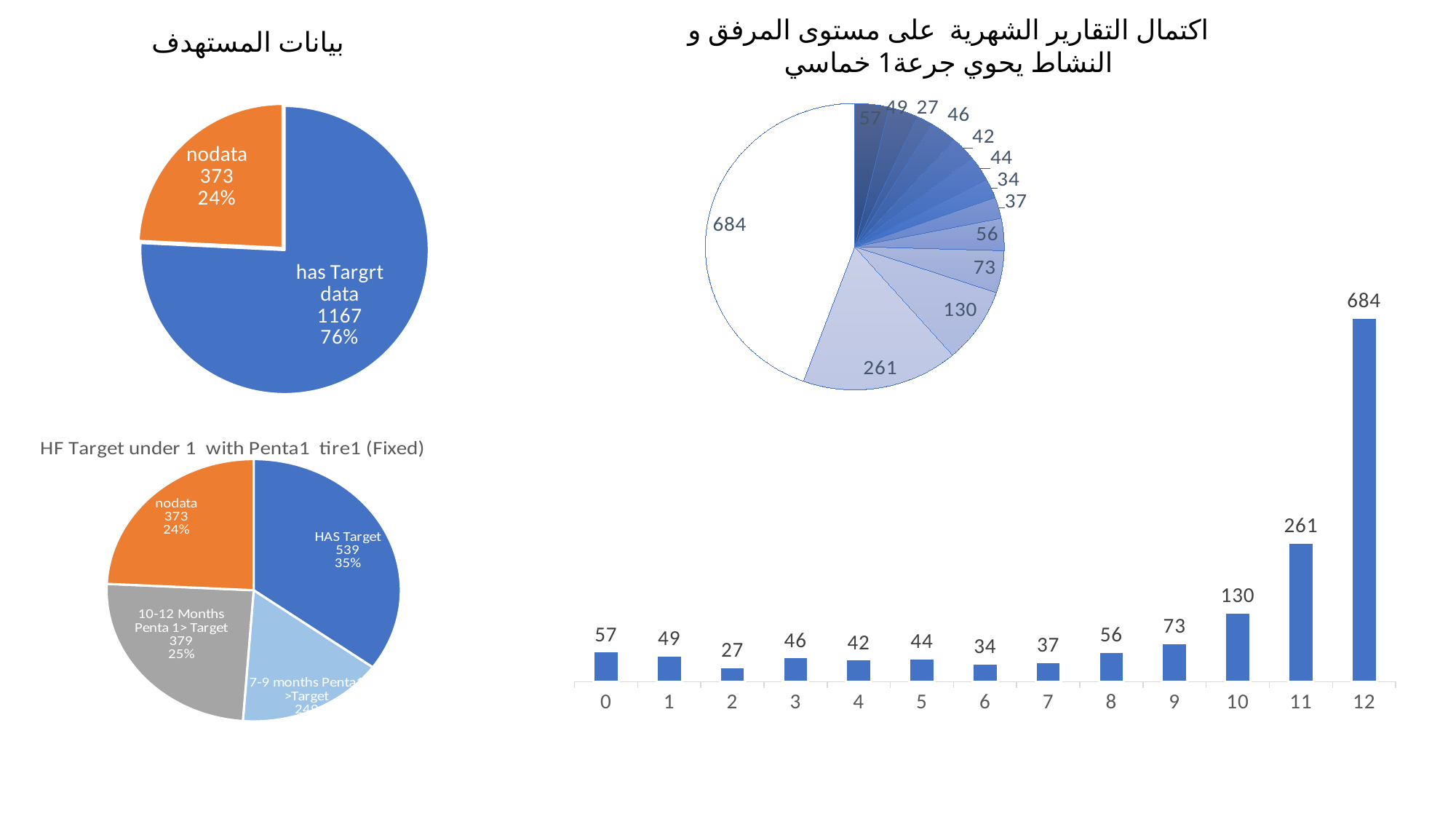
In the pie chart titled 'بيانات المستهدف', what share of the pie is 'has Targrt data'? 76% In the bar chart at the bottom right, which category has the highest value? 12 In the bar chart at the bottom right, what is the value for category 10? 130 In the pie chart titled 'HF Target under 1 with Penta1 tire1 (Fixed)', what share of the pie is '10-12 Months Penta 1> Target'? 25% In the bar chart at the bottom right, which is larger, the value for category 0 or the value for category 1? 0 In the pie chart titled 'بيانات المستهدف', what value is shown for 'nodata'? 373 In the bar chart at the bottom right, what is the value for category 12? 684 What kind of chart is the chart at the bottom right of the slide? bar chart In the bar chart at the bottom right, how many categories are shown on the x axis? 13 In the bar chart at the bottom right, which category has the lowest value? 2 In the pie chart titled 'HF Target under 1 with Penta1 tire1 (Fixed)', what value is shown for 'HAS Target'? 539 In the bar chart at the bottom right, what is the difference between the values for categories 12 and 11? 423